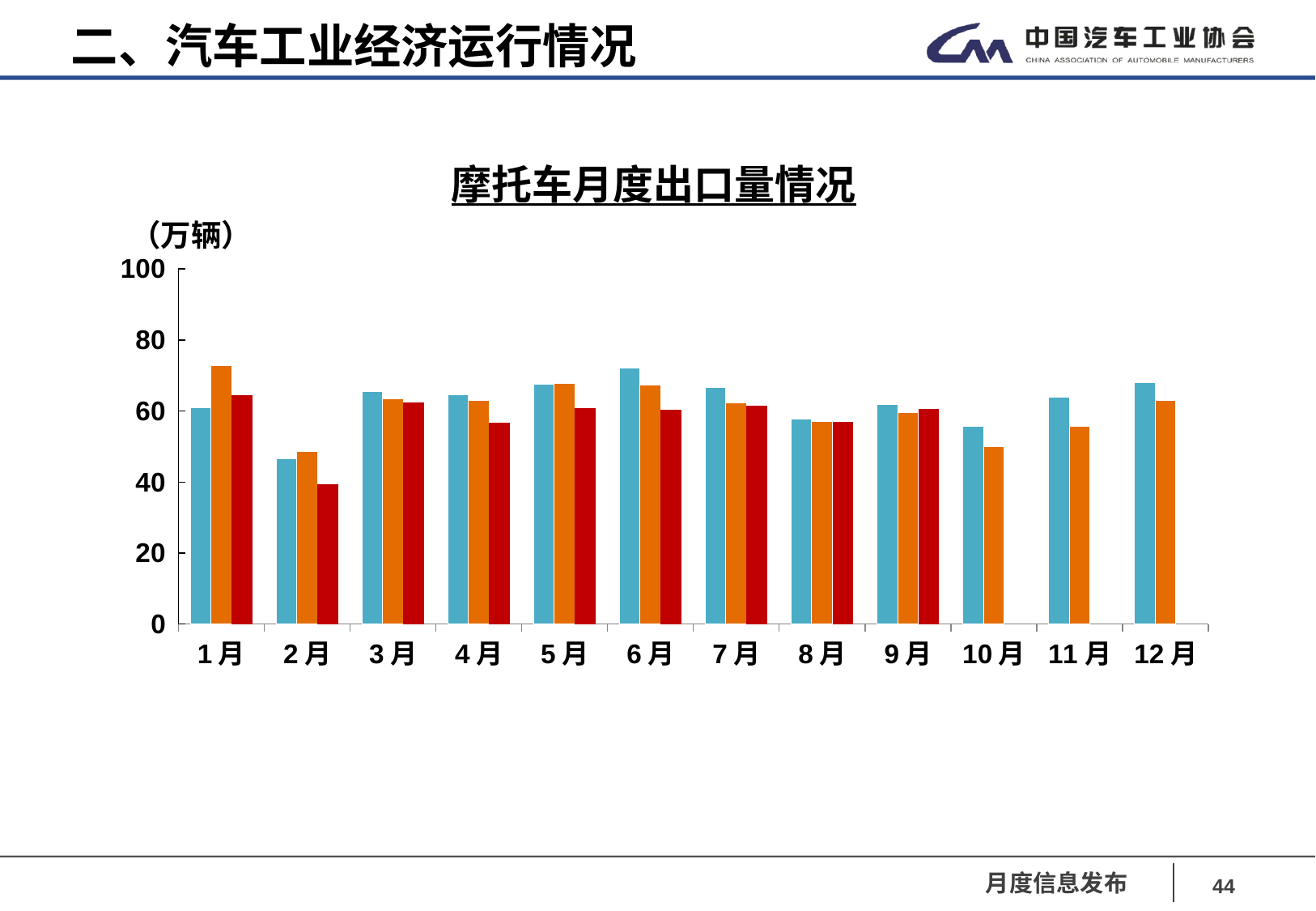
Which month has the lowest blue bar in the chart? 2月 How many months have a red bar in the chart? 9 In 2月, which is larger, the blue bar or the red bar? the blue bar Which month has the highest blue bar in the chart? 6月 What is the title of the chart? 摩托车月度出口量情况 Is the orange bar for 1月 greater or less than 60? greater What kind of chart is shown on the slide? bar chart Is the orange bar for 10月 greater or less than 60? less What unit is shown for the vertical axis of the chart? 万辆 How many months are shown along the x axis of the chart? 12 Do the blue bars rise or fall from 6月 to 8月? fall Which month has the highest orange bar in the chart? 1月